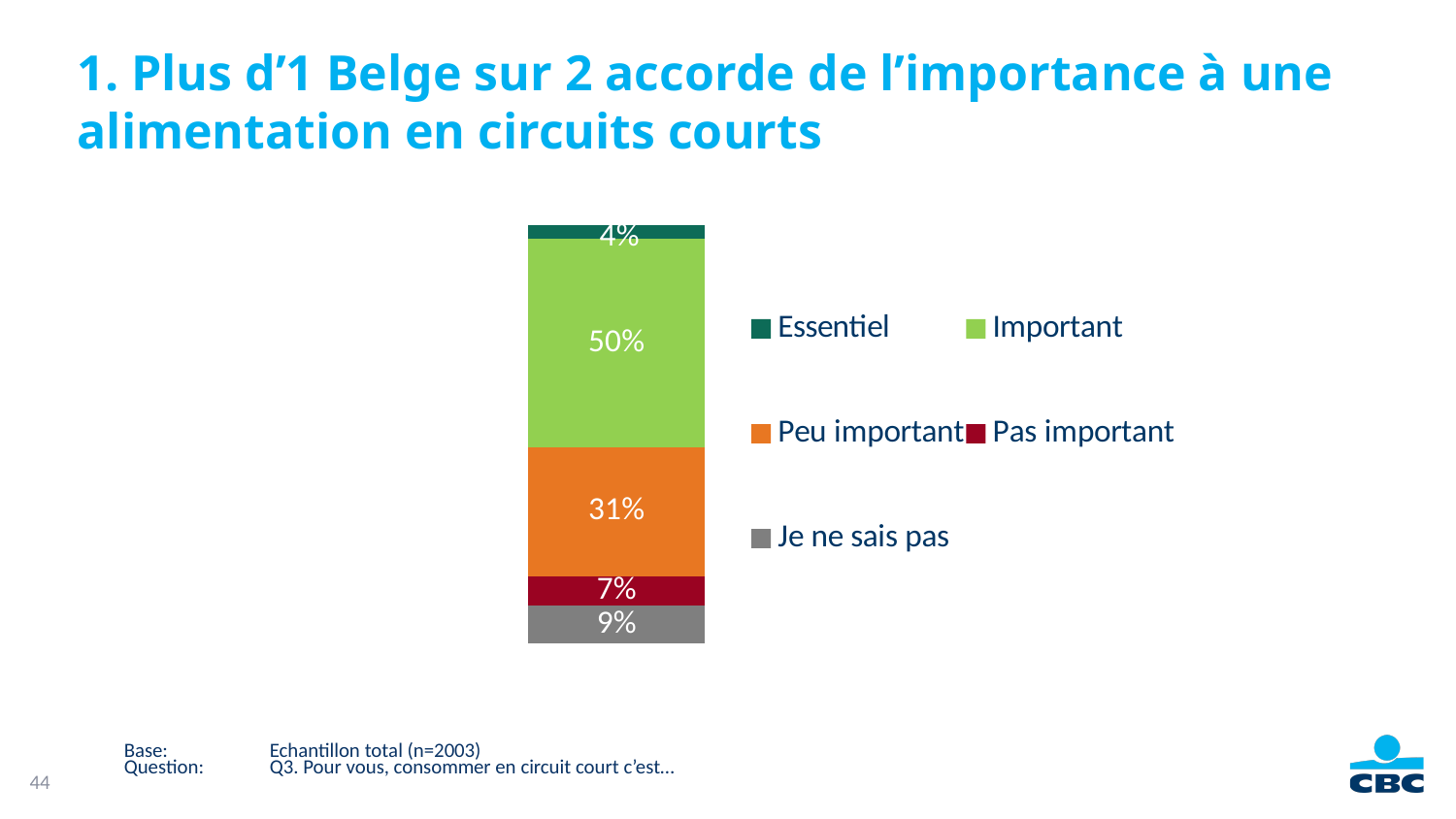
Which response category has the largest share? Important Which response category has the smallest share? Essentiel What is the difference in percentage points between "Important" and "Peu important"? 19 What percentage of respondents answered "Je ne sais pas"? 9% What percentage of respondents answered "Pas important"? 7% How many categories does the legend list? 5 What type of chart is shown on the slide? Stacked bar chart What is the combined percentage of "Essentiel" and "Important"? 54% Which is larger, the share for "Je ne sais pas" or the share for "Pas important"? Je ne sais pas What percentage of respondents answered "Peu important"? 31% What percentage of respondents answered "Important"? 50% What percentage of respondents answered "Essentiel"? 4%